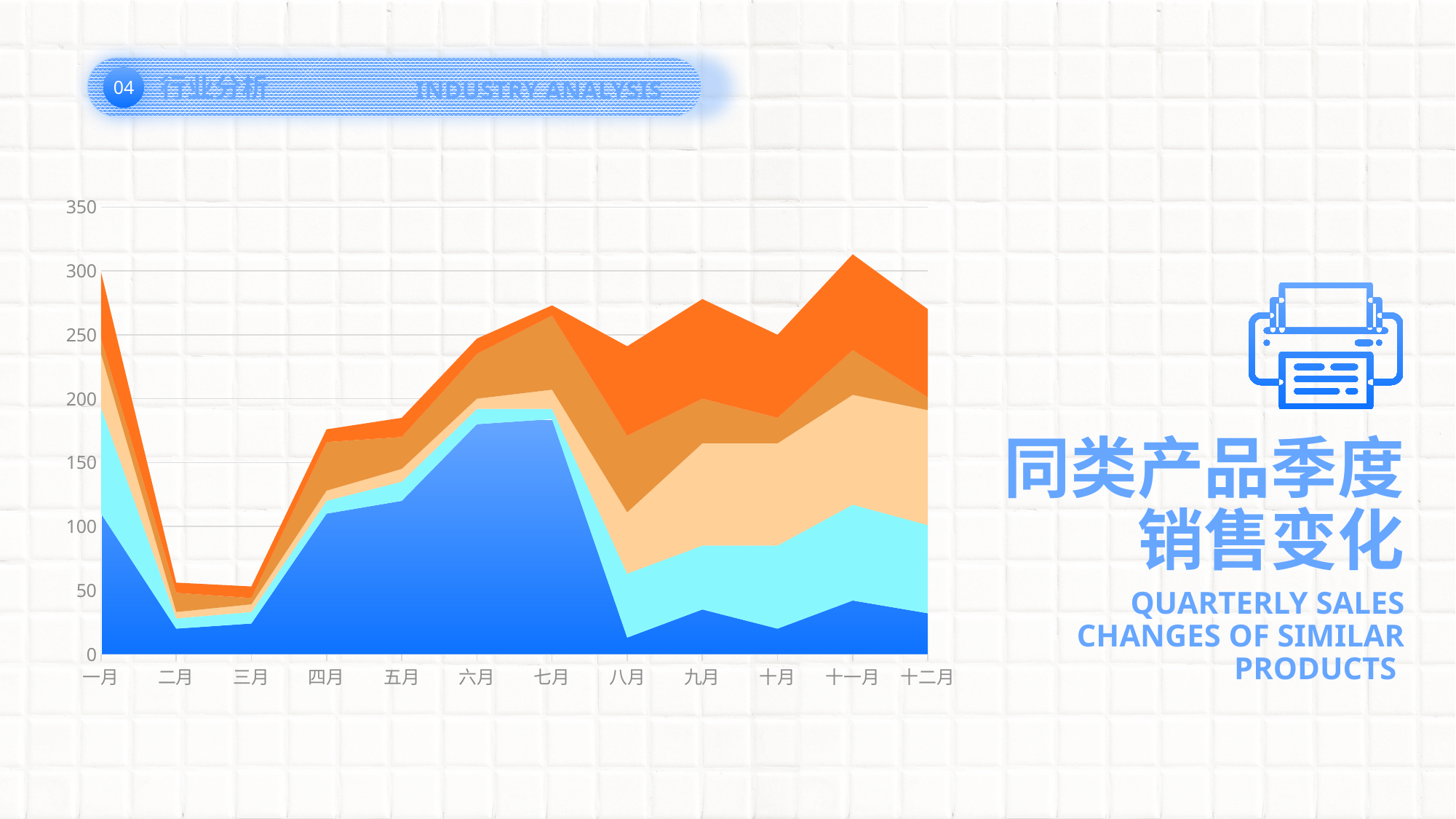
Is the total stacked value for 十二月 greater or less than 250? greater Is the total stacked value for 十一月 greater or less than 300? greater How many months are shown along the x axis of the chart? 12 How many coloured bands (series) are stacked in the chart? 5 Is the total stacked value for 二月 greater or less than 100? less What is the English title shown next to the chart? QUARTERLY SALES CHANGES OF SIMILAR PRODUCTS Does the total stacked value rise or fall from 三月 to 七月? rise Which month has the larger total stacked value, 七月 or 八月? 七月 Which month has the larger total stacked value, 十一月 or 十二月? 十一月 What kind of chart is shown on the slide? Stacked area chart